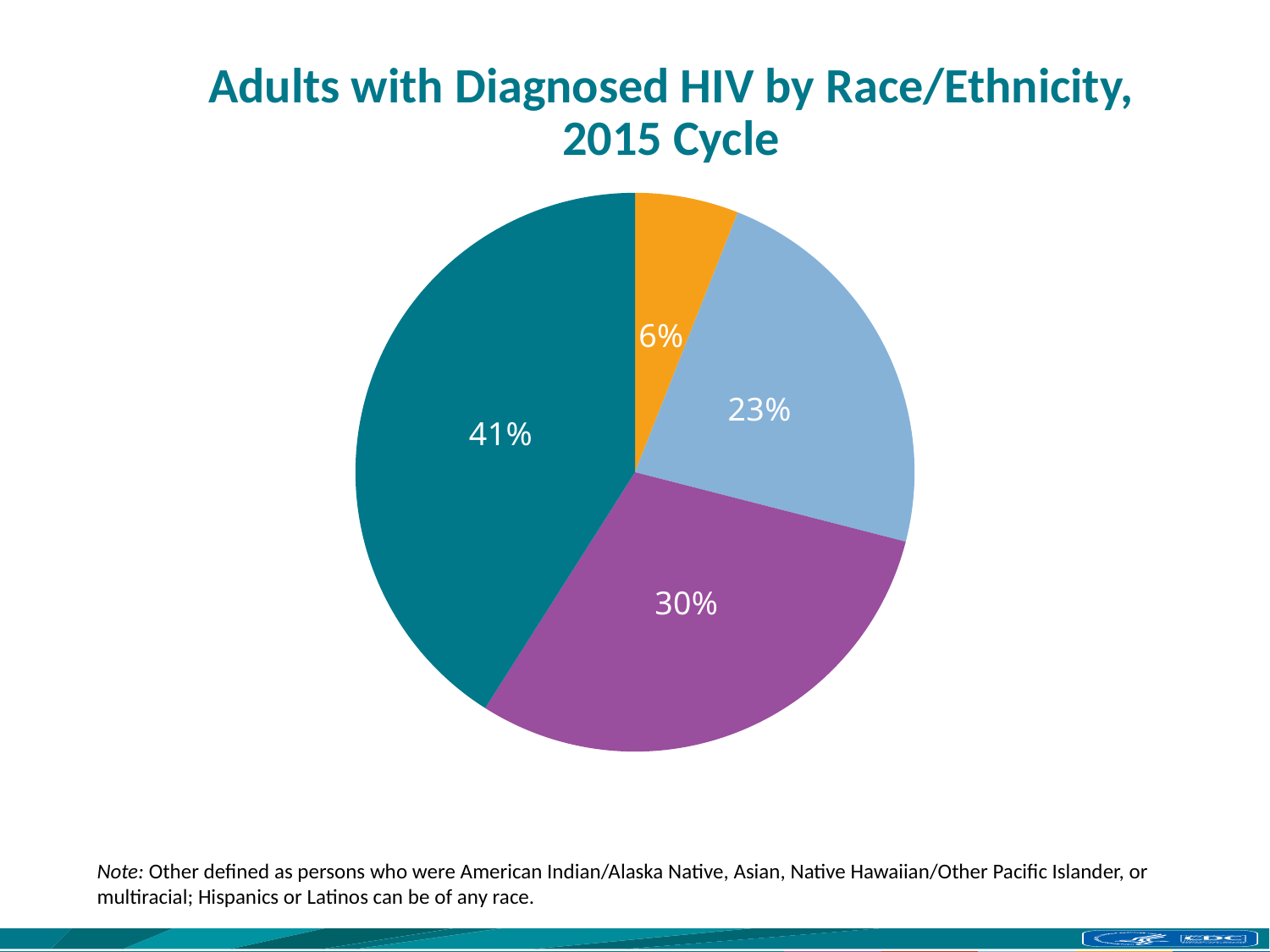
What share does the orange slice represent? 6% Is the largest slice of the pie chart greater or less than 50%? less What do the four slice percentages add up to? 100% What is the share of the largest slice in the pie chart? 41% What is the title of the chart? Adults with Diagnosed HIV by Race/Ethnicity, 2015 Cycle What is the difference in percentage points between the 30% slice and the 23% slice? 7 percentage points What is the share of the smallest slice in the pie chart? 6% What is the share of the third-largest slice in the pie chart? 23% What is the difference in percentage points between the largest and smallest slices? 35 percentage points What is the share of the second-largest slice in the pie chart? 30% What kind of chart is shown on the slide? pie chart How many slices does the pie chart have? 4